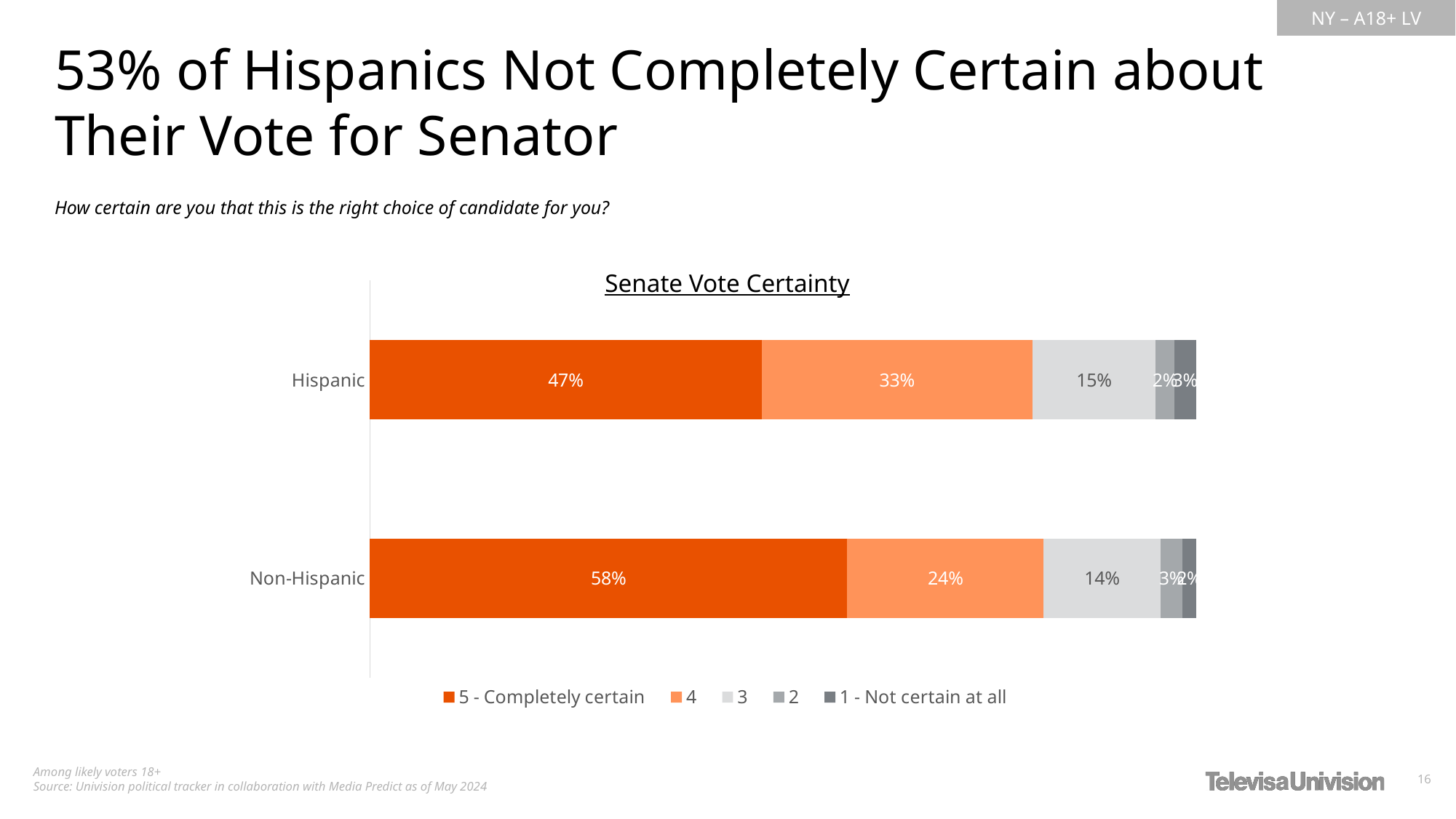
What is the value for the "4" rating among Hispanic respondents? 33% How many percentage points higher is the "5 - Completely certain" share for Non-Hispanic respondents than for Hispanic respondents? 11 percentage points What share of Non-Hispanic respondents gave a rating of "3"? 14% How many groups (categories) are shown in the chart? 2 What is the value for the "4" rating among Non-Hispanic respondents? 24% What share of Hispanic respondents gave a rating of "3"? 15% Which group has the larger share of "4" ratings, Hispanic or Non-Hispanic? Hispanic What type of chart is shown on the slide? Stacked bar chart How many series does the legend list? 5 Which group has the higher share of "5 - Completely certain" responses? Non-Hispanic What percentage of Hispanic respondents answered "5 - Completely certain"? 47% What percentage of Non-Hispanic respondents answered "5 - Completely certain"? 58%